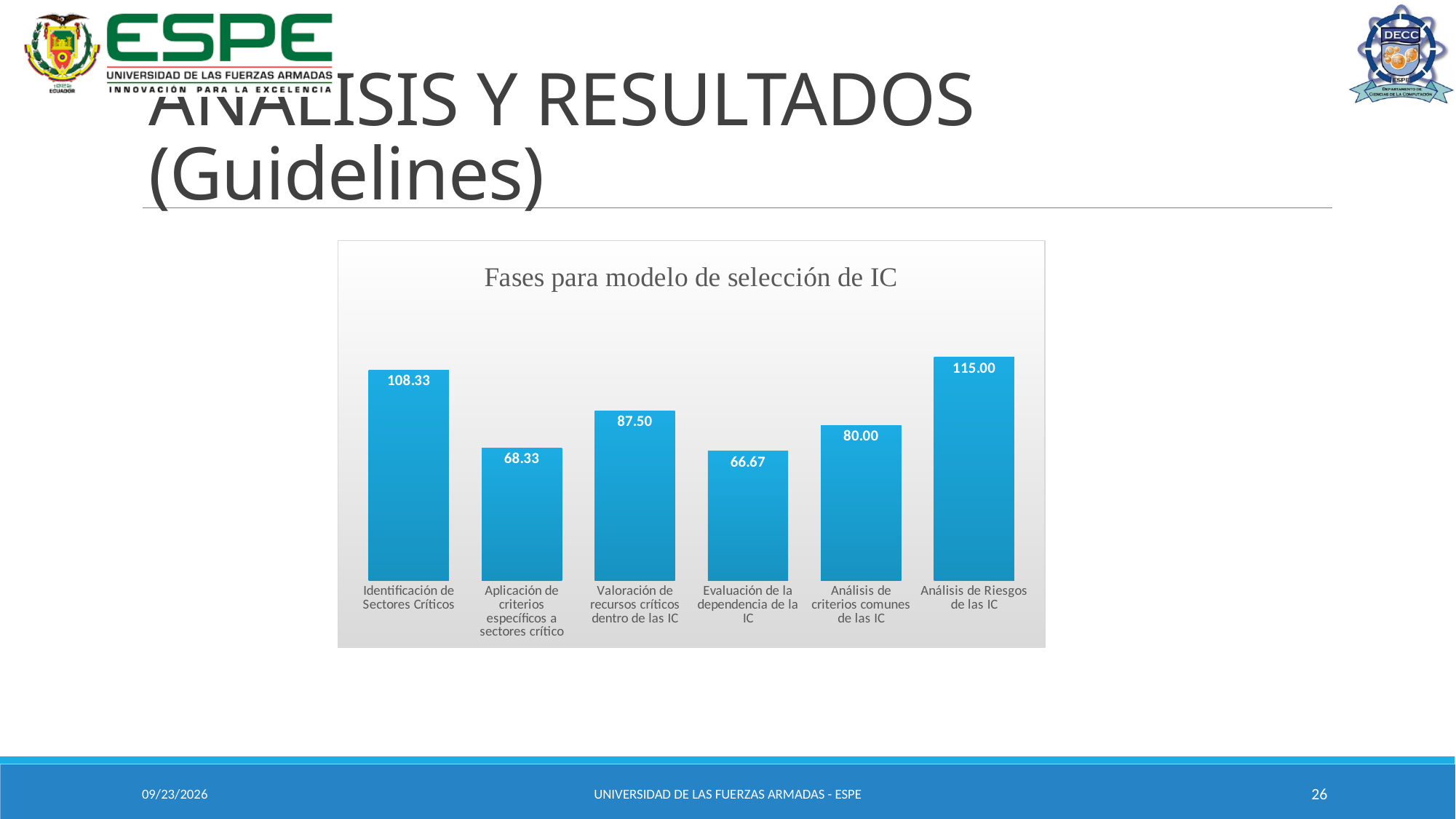
What is the value for 'Identificación de Sectores Críticos'? 108.33 What is the value for 'Evaluación de la dependencia de la IC'? 66.67 What is the value for 'Análisis de criterios comunes de las IC'? 80.00 Which category has the highest value? Análisis de Riesgos de las IC What colour are the bars in the chart? Blue Which category has the lowest value? Evaluación de la dependencia de la IC What is the difference between the values for 'Valoración de recursos críticos dentro de las IC' and 'Análisis de criterios comunes de las IC'? 7.50 Which is larger: the value for 'Aplicación de criterios específicos a sectores crítico' or the value for 'Valoración de recursos críticos dentro de las IC'? Valoración de recursos críticos dentro de las IC What kind of chart is shown on the slide? Bar chart How many categories are shown in the chart? 6 What is the title of the chart? Fases para modelo de selección de IC What is the difference between the values for 'Análisis de Riesgos de las IC' and 'Identificación de Sectores Críticos'? 6.67